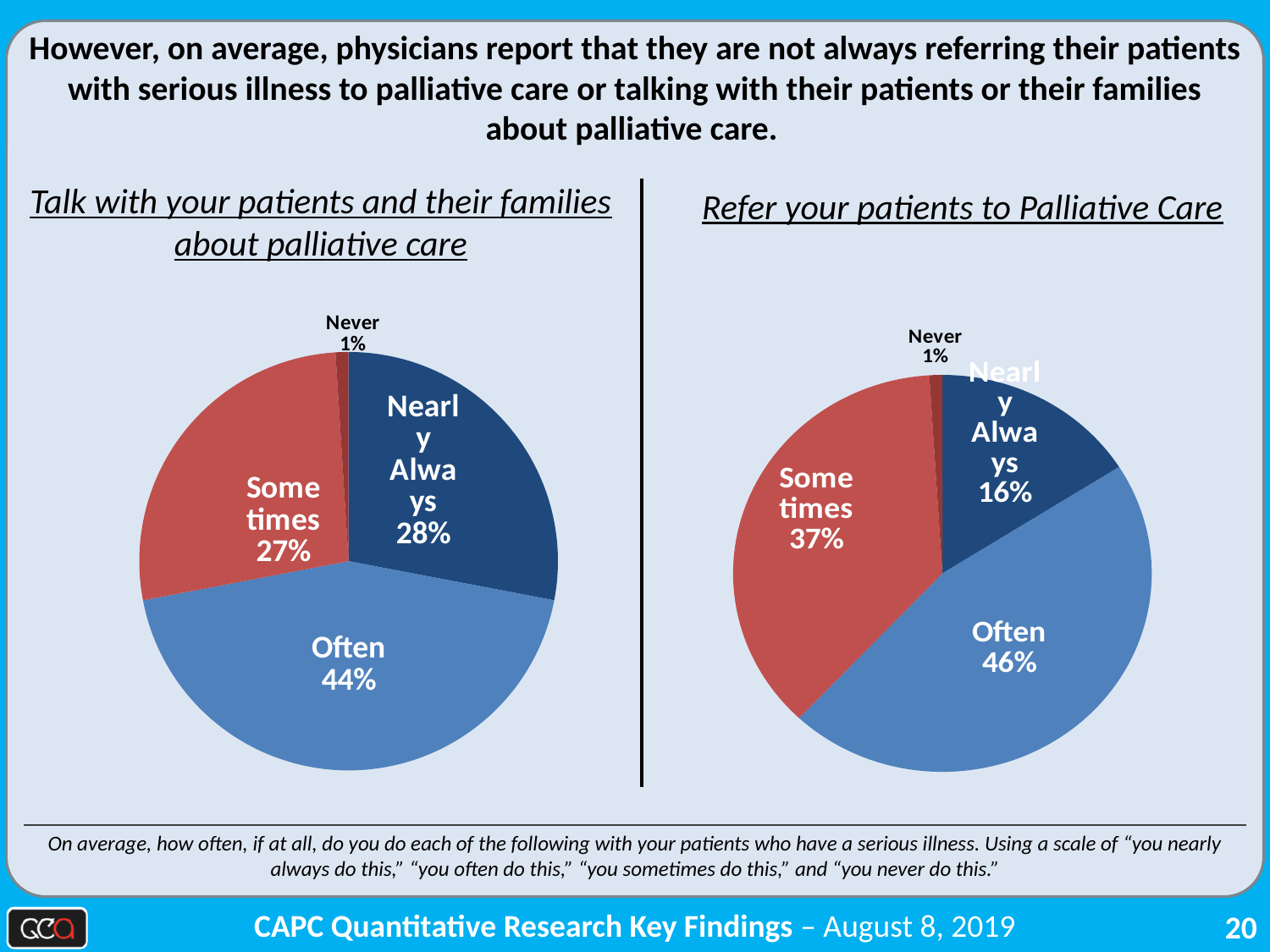
Which is larger: 'Nearly Always' in the 'Talk with your patients' pie chart or 'Nearly Always' in the 'Refer your patients' pie chart? Talk with your patients (28%) How many slices does the 'Refer your patients to Palliative Care' pie chart have? 4 In the 'Refer your patients to Palliative Care' pie chart, which category has the smallest slice? Never In the 'Talk with your patients and their families about palliative care' pie chart, what percentage is labelled 'Often'? 44% In the 'Talk with your patients and their families about palliative care' pie chart, is 'Sometimes' or 'Nearly Always' larger? Nearly Always In the 'Refer your patients to Palliative Care' pie chart, what percentage is labelled 'Nearly Always'? 16% In the 'Refer your patients to Palliative Care' pie chart, what is the difference between the 'Often' and 'Sometimes' percentages? 9% What is the title of the chart on the right side of the slide? Refer your patients to Palliative Care In the 'Refer your patients to Palliative Care' pie chart, what percentage is labelled 'Sometimes'? 37% In the 'Talk with your patients and their families about palliative care' pie chart, what is the difference between the 'Often' and 'Nearly Always' percentages? 16% What type of chart is used on the left side of the slide? Pie chart In the 'Talk with your patients and their families about palliative care' pie chart, which category has the largest slice? Often